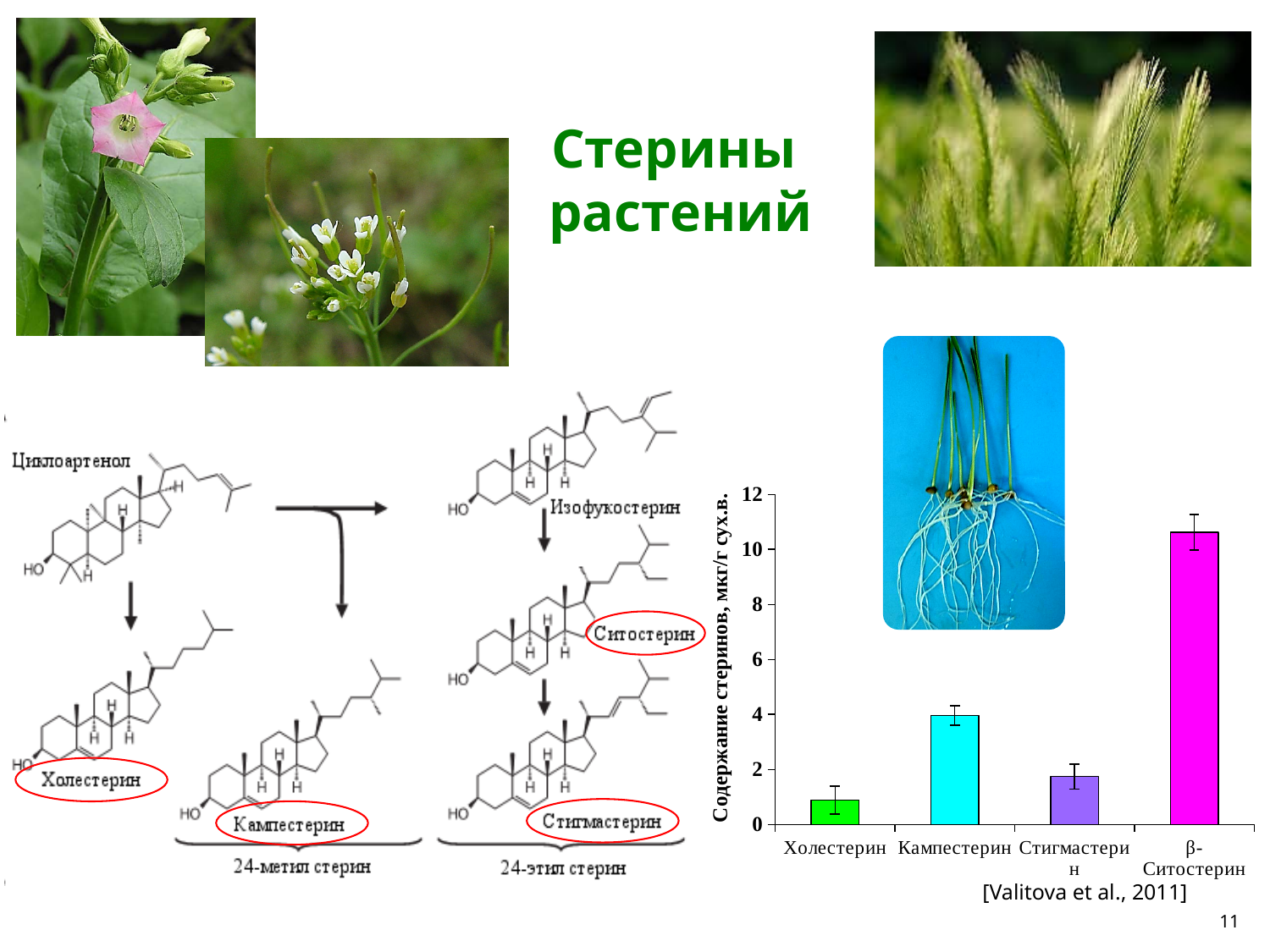
Is the value for β-Ситостерин greater or less than 8? greater Is the value for Стигмастерин greater or less than 4? less Which is larger on the bar chart, the value for Кампестерин or the value for Стигмастерин? Кампестерин Which category has the highest value on the bar chart? β-Ситостерин Is the value for Кампестерин greater or less than 2? greater How many categories are plotted on the bar chart? 4 What colour is the bar for β-Ситостерин? magenta Which category has the lowest value on the bar chart? Холестерин Which is larger on the bar chart, the value for Холестерин or the value for β-Ситостерин? β-Ситостерин What kind of chart is shown on the slide? bar chart What is the label of the vertical axis of the bar chart? Содержание стеринов, мкг/г сух.в.